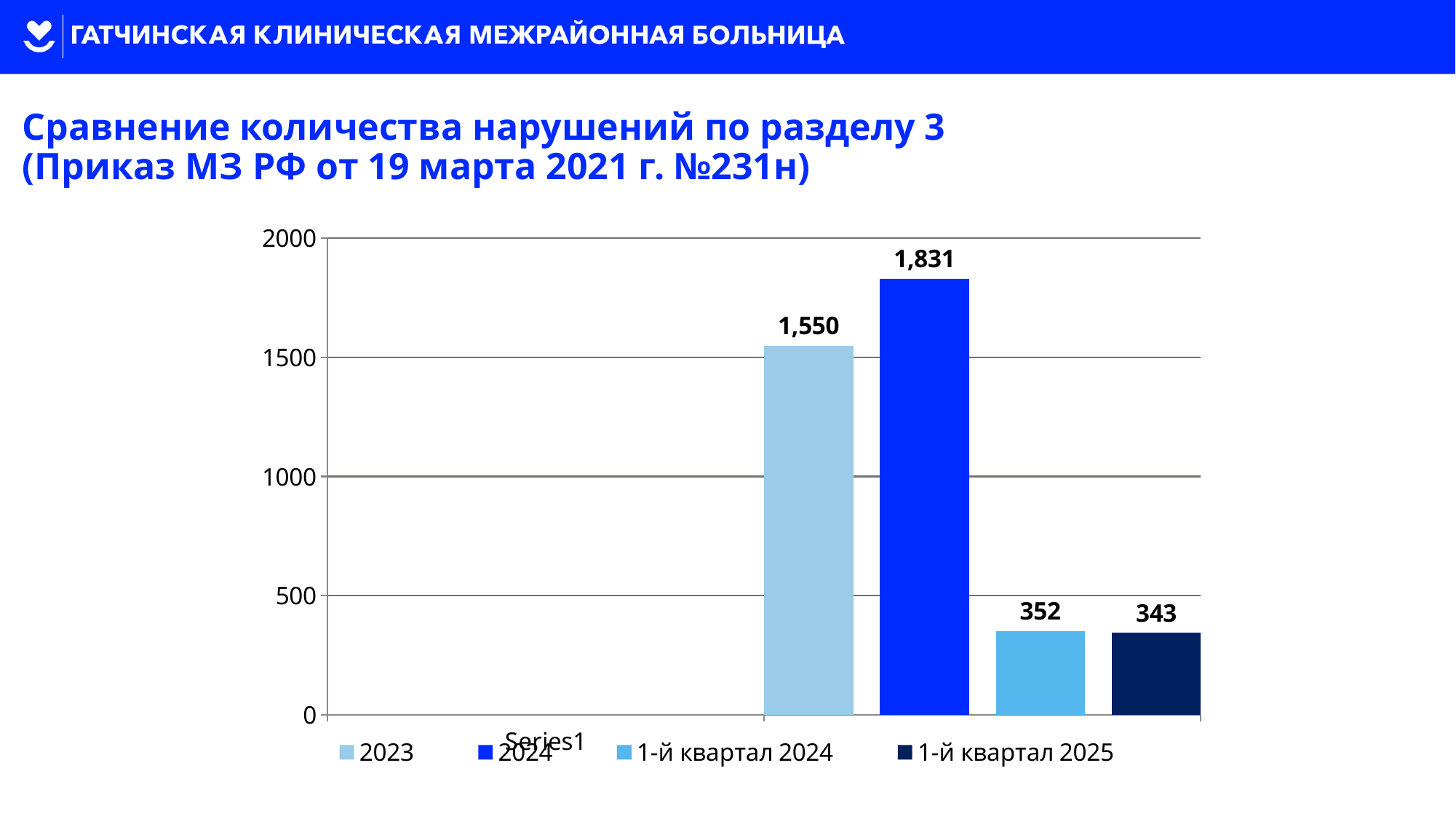
What is the difference between the values for 1-й квартал 2024 and 1-й квартал 2025? 9 What is the value for 1-й квартал 2025? 343 What is the difference between the values for 2024 and 2023? 281 What kind of chart is shown on the slide? bar chart Which is larger, the value for 2023 or the value for 2024? 2024 What is the value for 2024? 1,831 Which series has the highest value? 2024 How many series does the legend list? 4 What is the value for 2023? 1,550 What colour is the bar for 2024? blue What is the value for 1-й квартал 2024? 352 Which series has the lowest value? 1-й квартал 2025